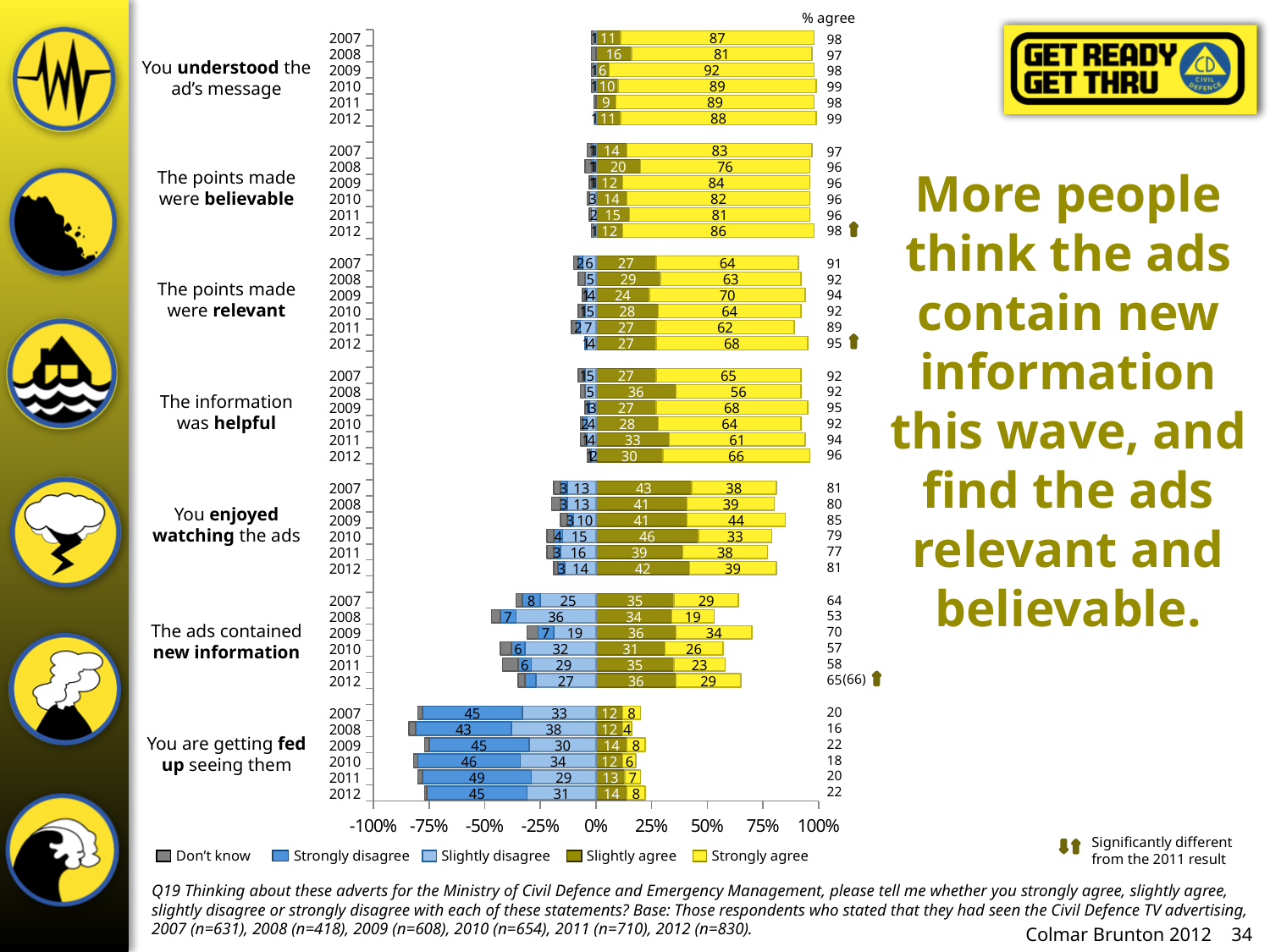
What is the Slightly agree value for 'You enjoyed watching the ads' in 2010? 46 For 'You are getting fed up seeing them', which year has the lowest % agree figure? 2008 How many series does the legend list? 5 For 'The information was helpful', which year has the larger Strongly agree value, 2008 or 2012? 2012 For 'The ads contained new information', which year has the lowest % agree figure? 2008 What is the % agree figure for 'The ads contained new information' in 2008? 53 For 'You enjoyed watching the ads', which year has the highest % agree figure? 2009 What kind of chart is shown on the slide? Bar chart By how much did the % agree figure for 'The points made were relevant' increase from 2011 to 2012? 6 What is the Strongly disagree value for 'You are getting fed up seeing them' in 2011? 49 What is the Strongly agree value for 'You understood the ad's message' in 2009? 92 How many years are plotted for each statement? 6